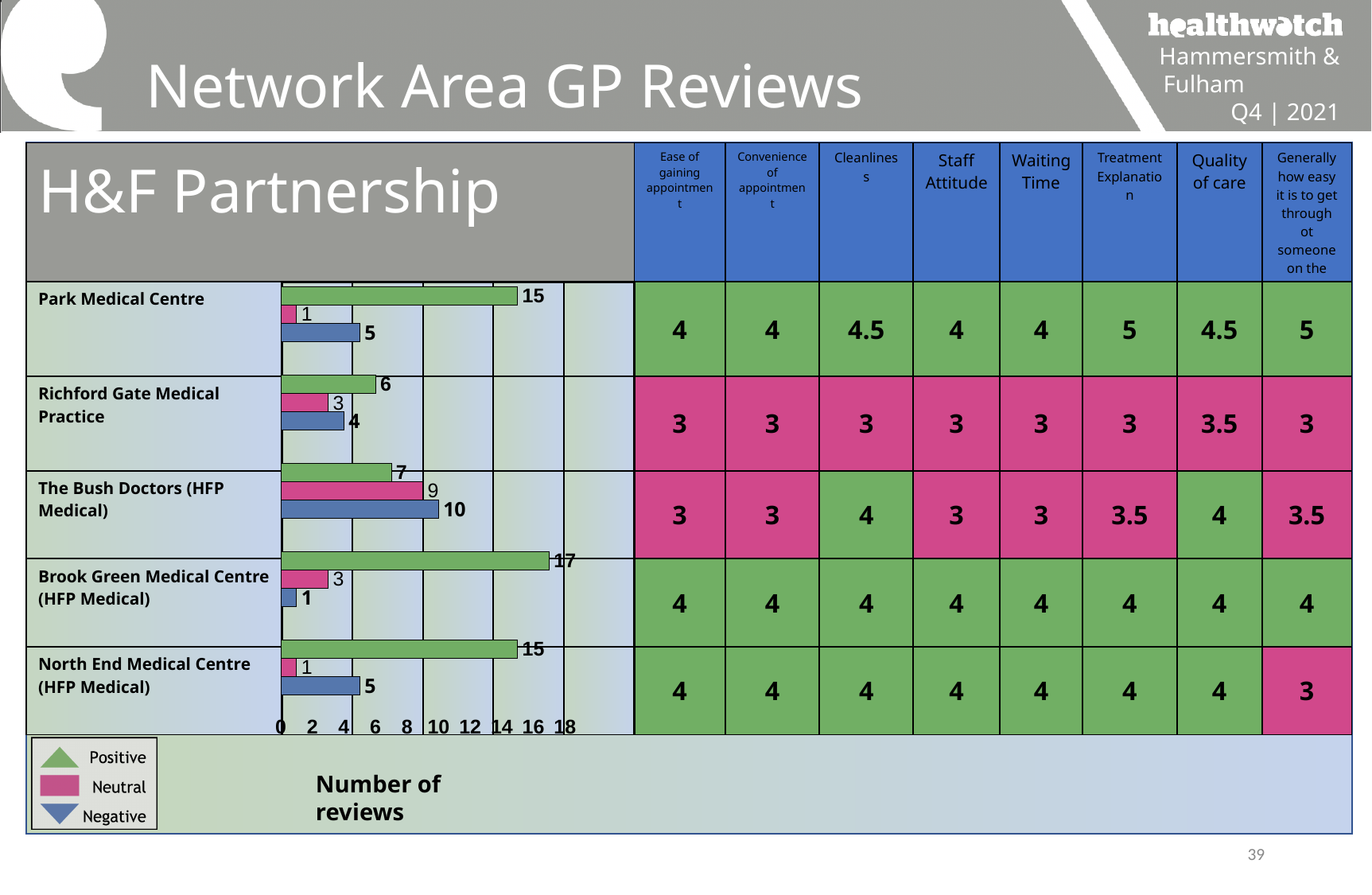
Which practice has the highest number of positive reviews? Brook Green Medical Centre (HFP Medical) How many negative reviews does The Bush Doctors (HFP Medical) have? 10 What are the three categories listed in the chart legend? Positive, Neutral, Negative How many practices are shown in the bar chart? 5 How many series does the chart legend list? 3 Which is larger for The Bush Doctors (HFP Medical): the number of neutral reviews or the number of positive reviews? Neutral reviews How many positive reviews does Brook Green Medical Centre (HFP Medical) have? 17 Which practice has the lowest number of positive reviews? Richford Gate Medical Practice What is the difference between the positive and negative reviews for Park Medical Centre? 10 What type of chart is used to show the number of reviews? Bar chart How many neutral reviews does Richford Gate Medical Practice have? 3 What is the total number of reviews for North End Medical Centre (HFP Medical) across positive, neutral and negative? 21